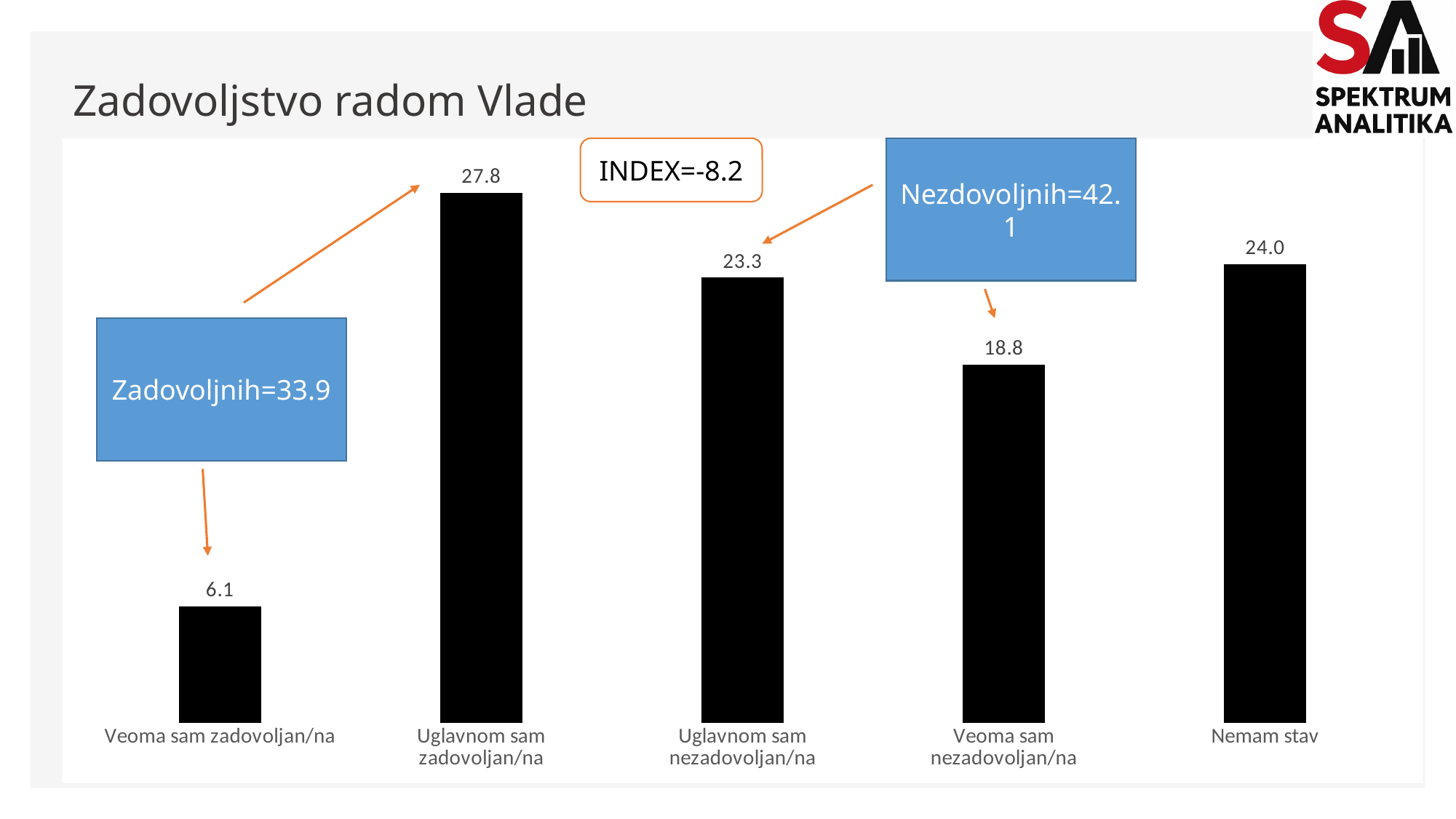
What is the value for "Uglavnom sam nezadovoljan/na"? 23.3 What is the value for "Veoma sam zadovoljan/na"? 6.1 What is the difference between the values for "Uglavnom sam zadovoljan/na" and "Uglavnom sam nezadovoljan/na"? 4.5 Which category has the lowest value? Veoma sam zadovoljan/na What is the title of the slide? Zadovoljstvo radom Vlade How many categories are shown in the chart? 5 Which category has the highest value? Uglavnom sam zadovoljan/na What is the value for "Uglavnom sam zadovoljan/na"? 27.8 What is the value for "Veoma sam nezadovoljan/na"? 18.8 What is the value for "Nemam stav"? 24.0 Which is larger, the value for "Nemam stav" or the value for "Veoma sam nezadovoljan/na"? Nemam stav What kind of chart is shown on the slide? Bar chart